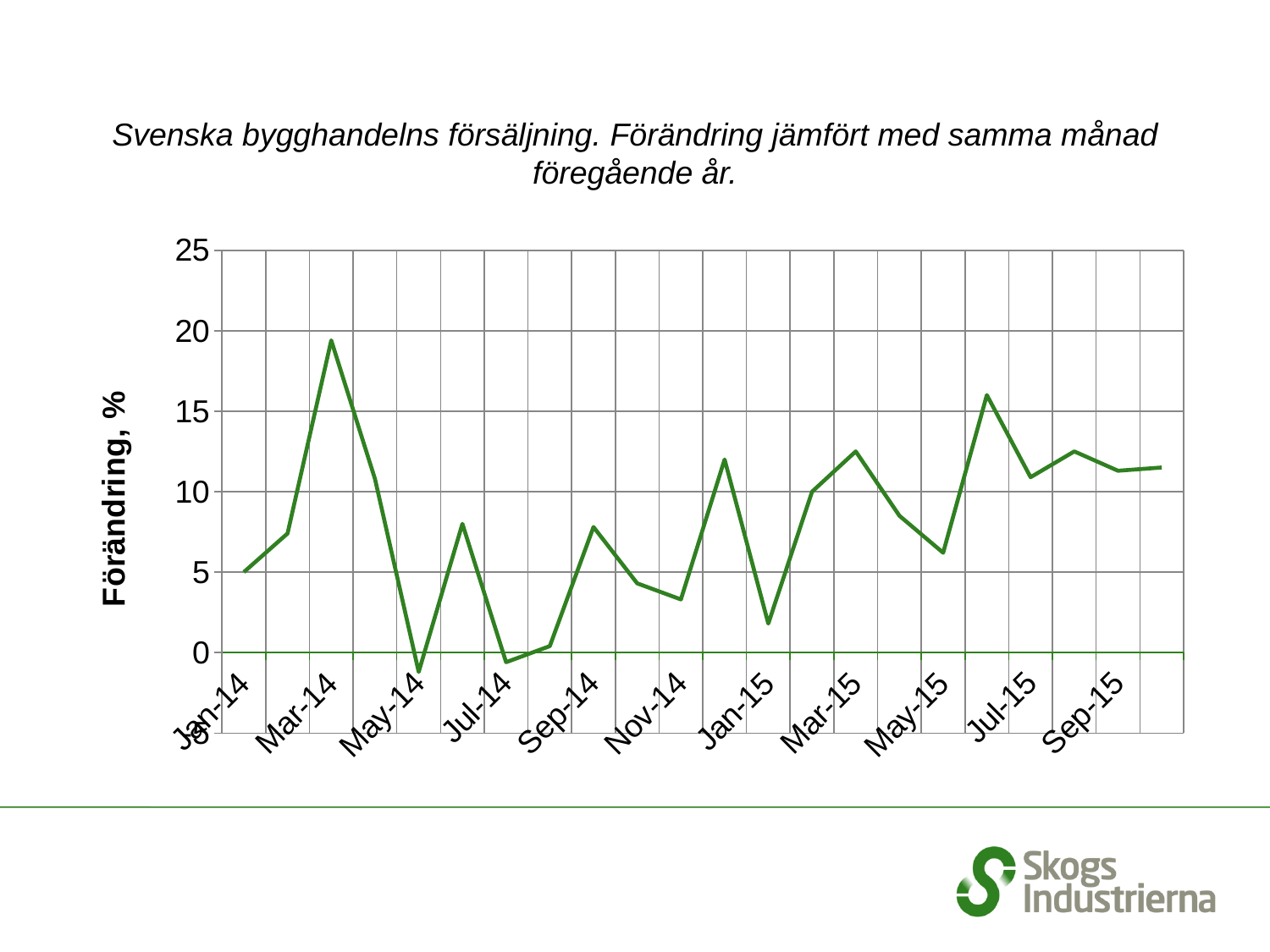
Is the value for Jul-15 greater or less than 10? greater Is the value for Sep-14 greater or less than 5? greater What is the label of the vertical axis? Förändring, % Is the value for Mar-15 greater or less than 10? greater Which is larger, the value for Mar-14 or the value for Jul-15? Mar-14 Does the line rise or fall from Jan-14 to Mar-14? rise What kind of chart is shown on the slide? line chart Which is larger, the value for Sep-14 or the value for Nov-14? Sep-14 Which month has the highest value on the chart? Mar-14